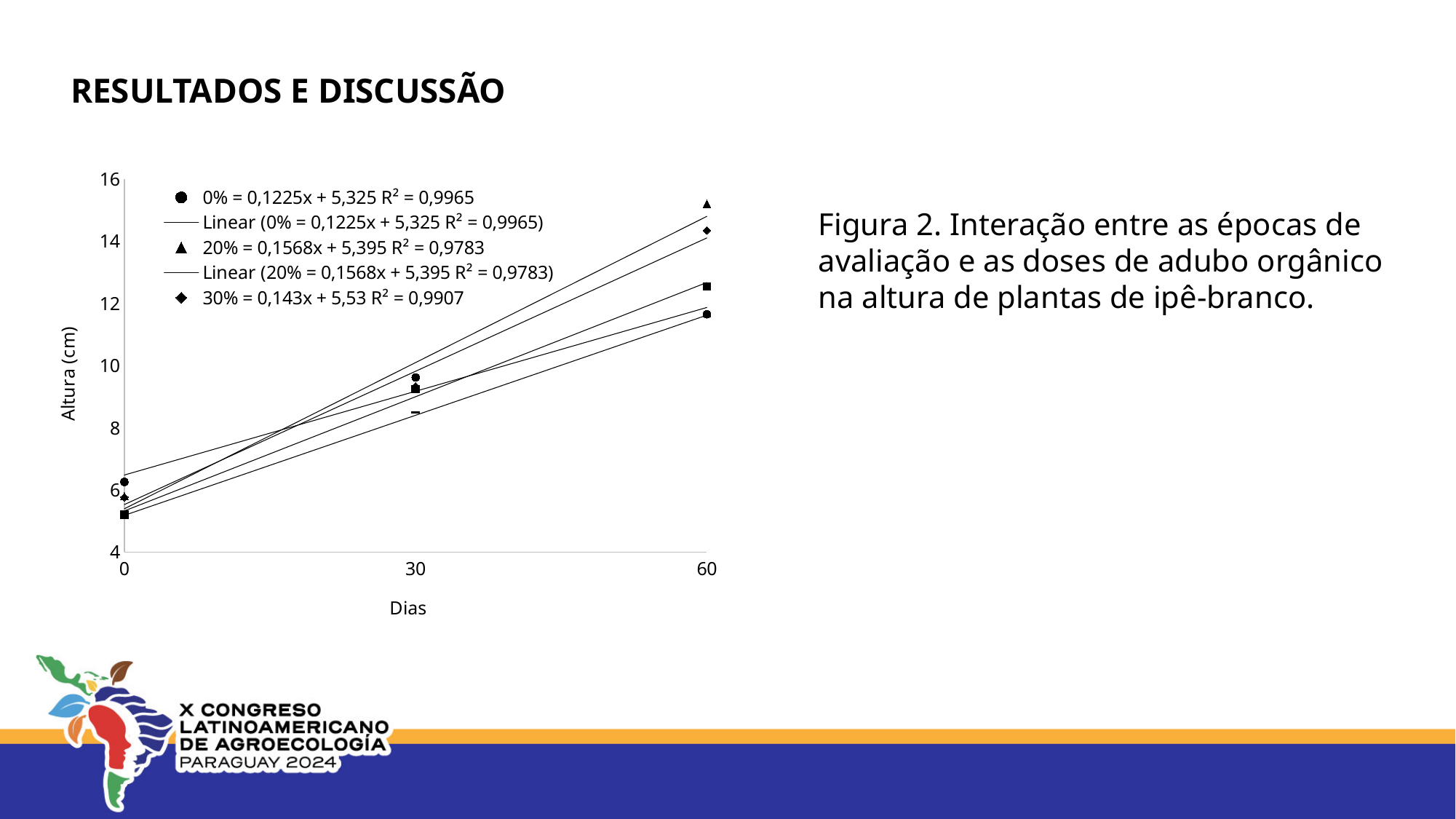
At 60 days, is the height for the 0% dose greater or less than 12 cm? less What is the R² value given for the 0% dose equation? 0,9965 At 60 days, is the height for the 20% dose greater or less than 14 cm? greater What is the label of the y axis of the chart? Altura (cm) How many time points (Dias) are shown on the x axis of the chart? 3 Do the plant heights rise or fall as the number of days increases? Rise At 60 days, which is larger: the height for the 20% dose or the 0% dose? 20% What is the slope given in the equation for the 30% dose? 0,143 How many entries does the chart legend list? 5 Which dose series has the highest height at 60 days? 20% What kind of chart is shown on the slide? Scatter chart